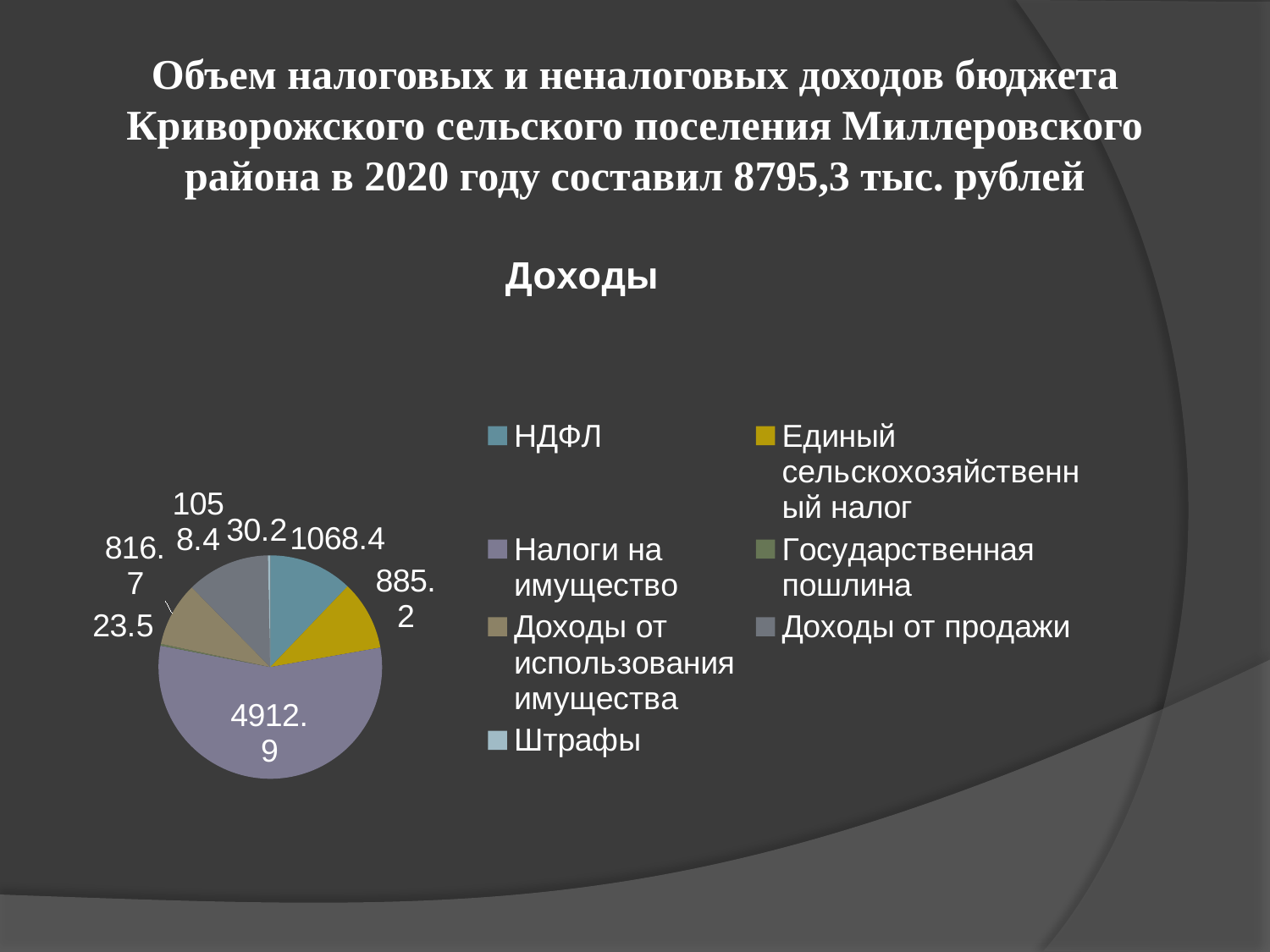
What type of chart is shown on the slide? pie chart What is the value for Единый сельскохозяйственный налог? 885.2 Which category has the largest slice of the pie? Налоги на имущество What is the value for Налоги на имущество? 4912.9 What is the value for Государственная пошлина? 23.5 What is the title of the chart? Доходы Which is larger, НДФЛ or Единый сельскохозяйственный налог? НДФЛ What is the value for НДФЛ? 1068.4 How many entries does the chart legend list? 7 What is the value for Доходы от использования имущества? 816.7 What is the difference between Налоги на имущество and НДФЛ? 3844.5 What is the difference between НДФЛ and Единый сельскохозяйственный налог? 183.2